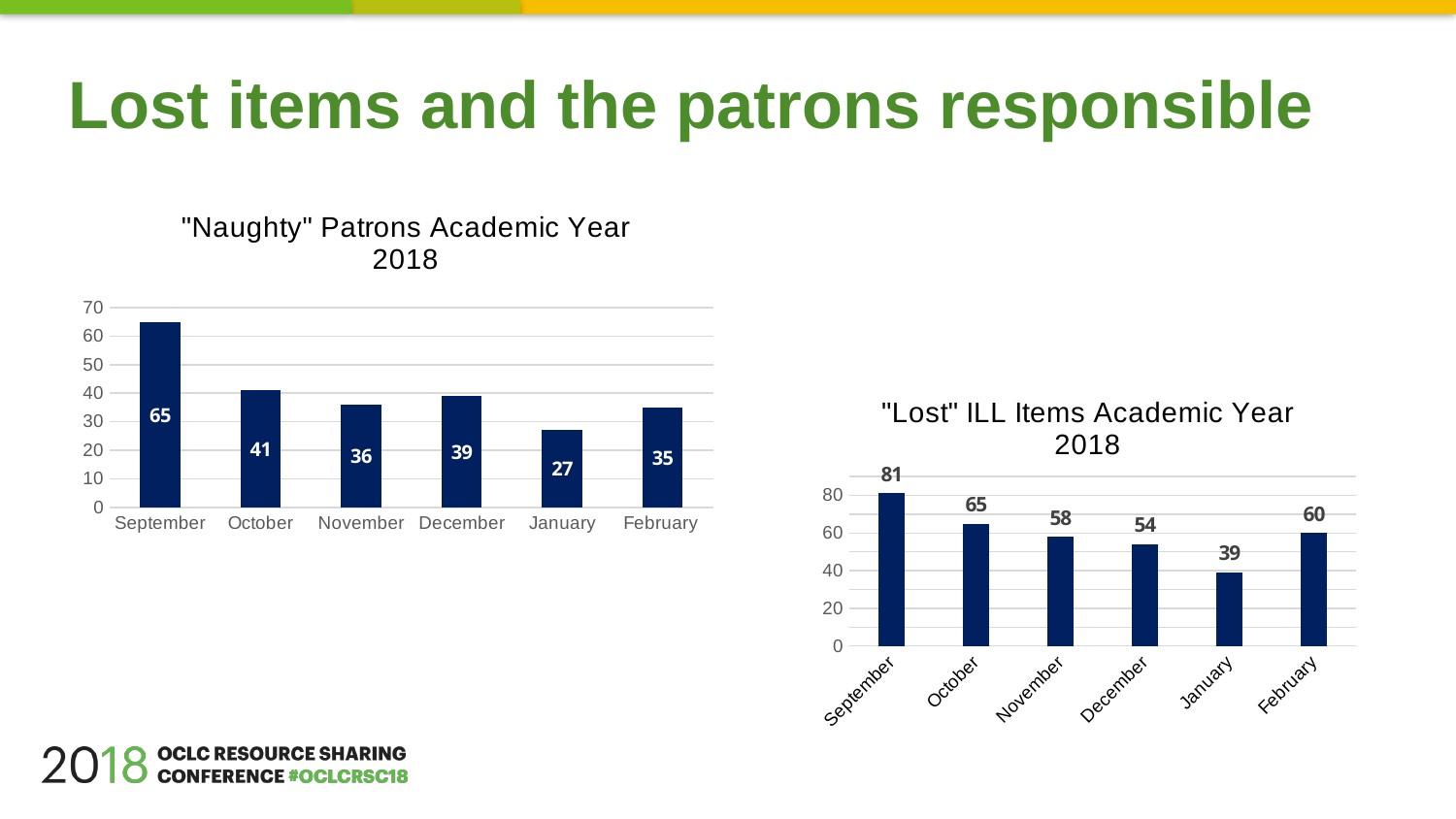
In the "Naughty" Patrons Academic Year 2018 chart, which is larger, the value for November or the value for December? December In the "Naughty" Patrons Academic Year 2018 chart, which month has the lowest value? January In the "Lost" ILL Items Academic Year 2018 chart, what is the difference between the values for September and October? 16 In the "Lost" ILL Items Academic Year 2018 chart, which month has the highest value? September In the "Lost" ILL Items Academic Year 2018 chart, what is the value for November? 58 In the "Naughty" Patrons Academic Year 2018 chart, what is the value for September? 65 In the "Lost" ILL Items Academic Year 2018 chart, what is the value for January? 39 What kind of chart is the "Naughty" Patrons Academic Year 2018 chart? Bar chart In the "Naughty" Patrons Academic Year 2018 chart, what is the difference between the values for October and January? 14 In the "Lost" ILL Items Academic Year 2018 chart, which is larger, the value for December or the value for February? February What is the title of the chart on the left side of the slide? "Naughty" Patrons Academic Year 2018 How many months are shown on the x axis of the "Lost" ILL Items Academic Year 2018 chart? 6